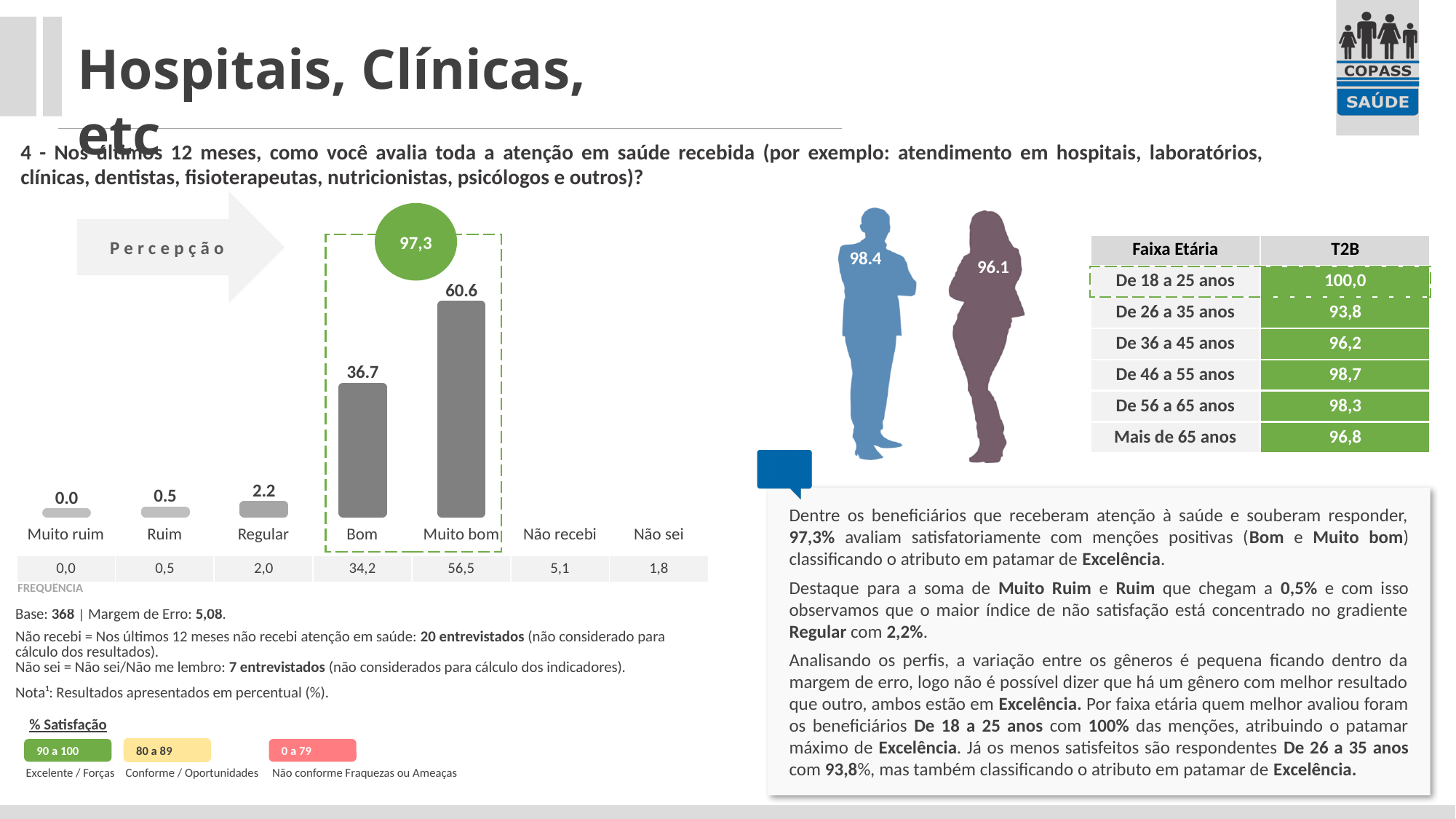
What kind of chart is used to show the evaluation categories? Bar chart What is the value shown for the 'Bom' bar? 36.7 What is the value shown for the 'Muito bom' bar? 60.6 How many category labels appear along the x axis of the chart? 7 What is the value shown for the 'Regular' bar? 2.2 What value is printed in the green circle above the highlighted bars? 97,3 What is the combined value of the 'Bom' and 'Muito bom' bars? 97.3 Which category has the lowest value among the labelled bars? Muito ruim Which category has the highest bar in the chart? Muito bom Which is larger, the value for 'Bom' or the value for 'Regular'? Bom What is the value shown for the 'Ruim' bar? 0.5 What is the difference between the 'Muito bom' and 'Bom' values? 23.9